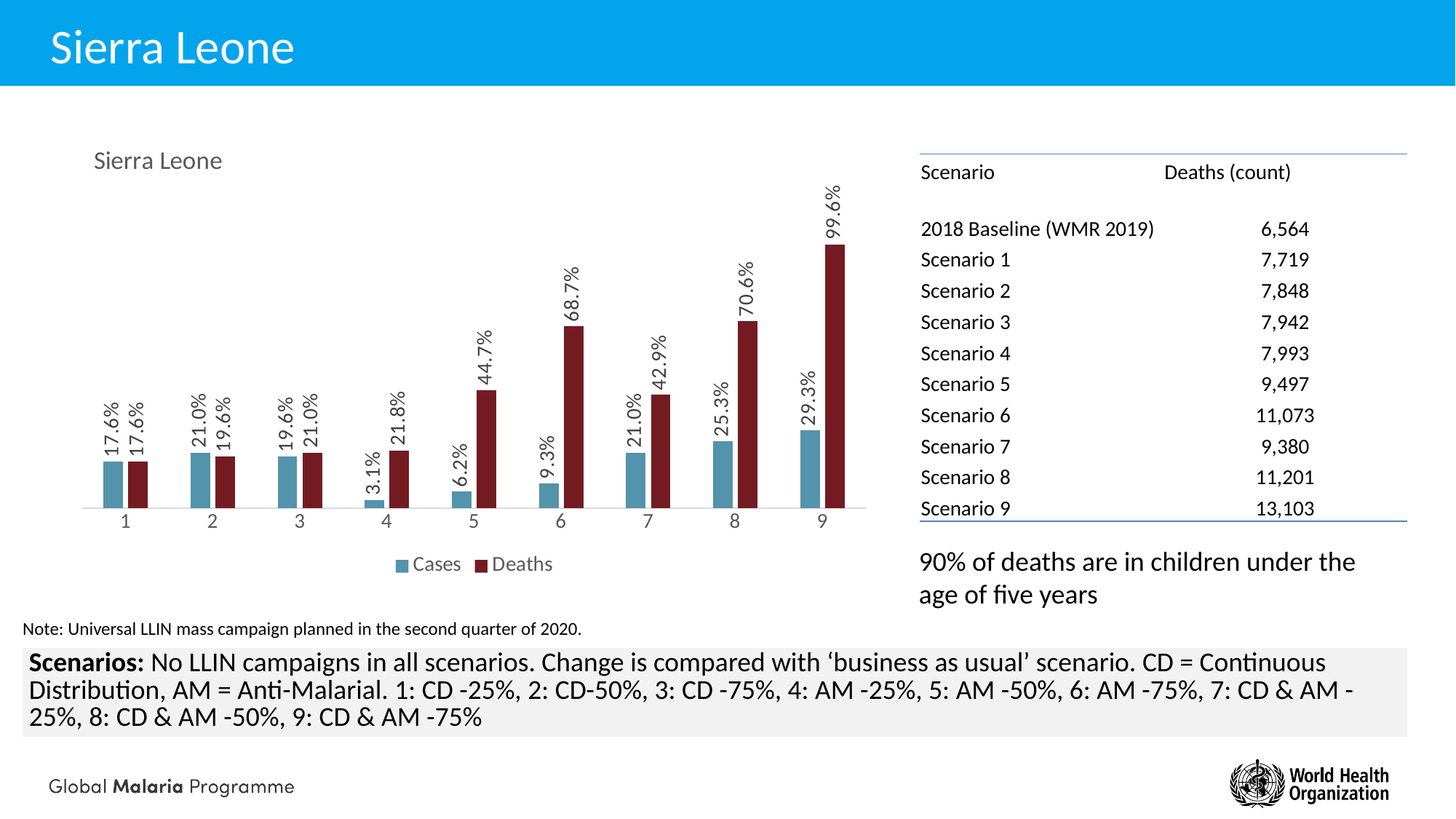
What is the title of the chart? Sierra Leone What is the Cases value for scenario 4? 3.1% Which series is shown in dark red in the chart? Deaths What is the Deaths value for scenario 6? 68.7% Which is larger for scenario 5: the Cases value or the Deaths value? Deaths How many series does the chart legend list? 2 What kind of chart is shown on the slide? Bar chart What is the Deaths value for scenario 9? 99.6% What is the difference between the Deaths and Cases values for scenario 8? 45.3% Which scenario has the highest Deaths value? 9 Which scenario has the lowest Cases value? 4 How many scenarios are shown on the x axis of the chart? 9